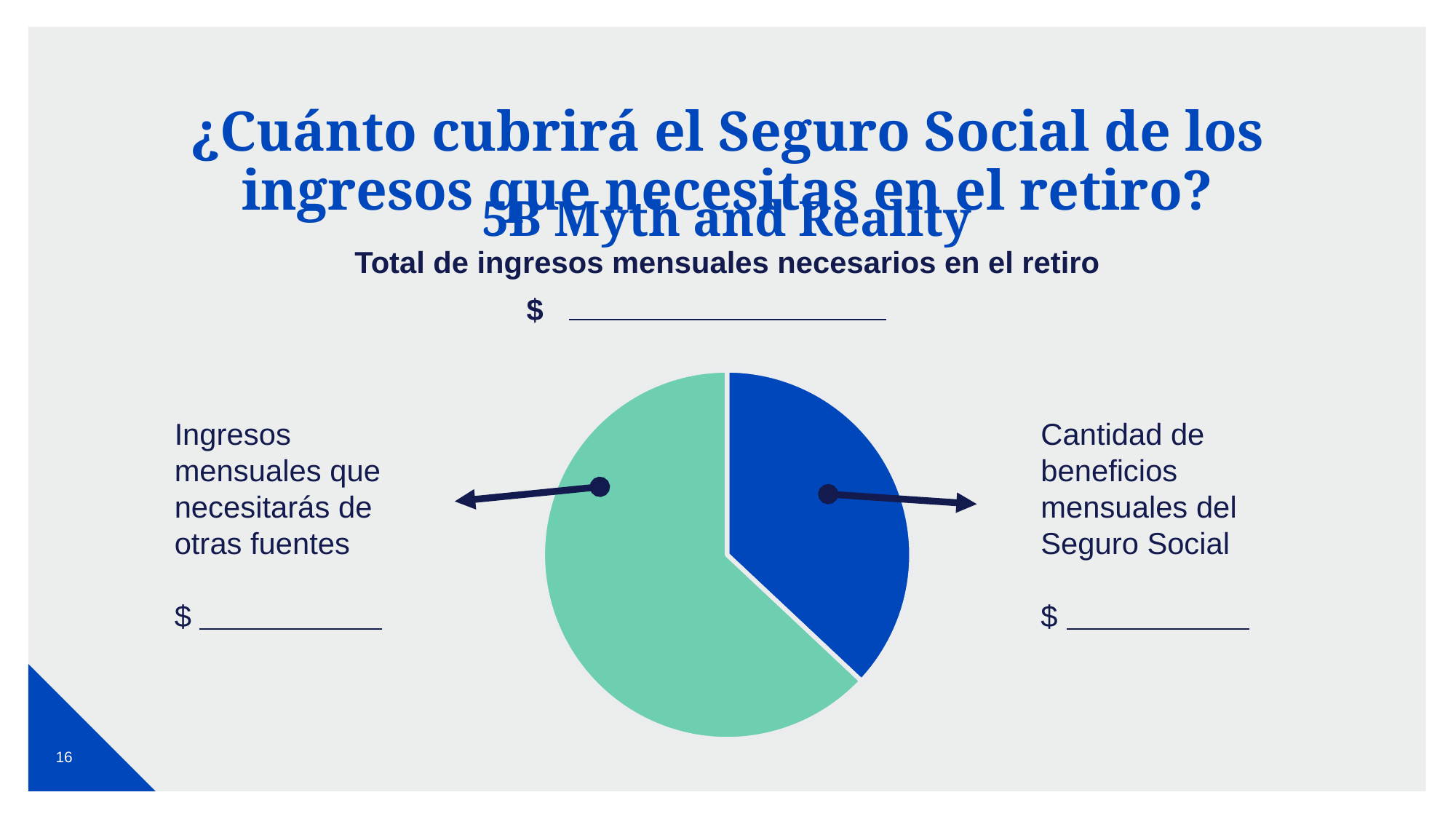
What colour is the slice labelled 'Cantidad de beneficios mensuales del Seguro Social'? Blue Does the 'Cantidad de beneficios mensuales del Seguro Social' slice take up more or less than half of the pie? Less Which slice of the pie chart is the largest? Ingresos mensuales que necesitarás de otras fuentes How many slices does the pie chart have? 2 What kind of chart is shown on the slide? Pie chart What colour is the slice labelled 'Ingresos mensuales que necesitarás de otras fuentes'? Teal (green) Which is larger in the pie chart: the slice for 'Ingresos mensuales que necesitarás de otras fuentes' or the slice for 'Cantidad de beneficios mensuales del Seguro Social'? Ingresos mensuales que necesitarás de otras fuentes Which slice of the pie chart is the smallest? Cantidad de beneficios mensuales del Seguro Social